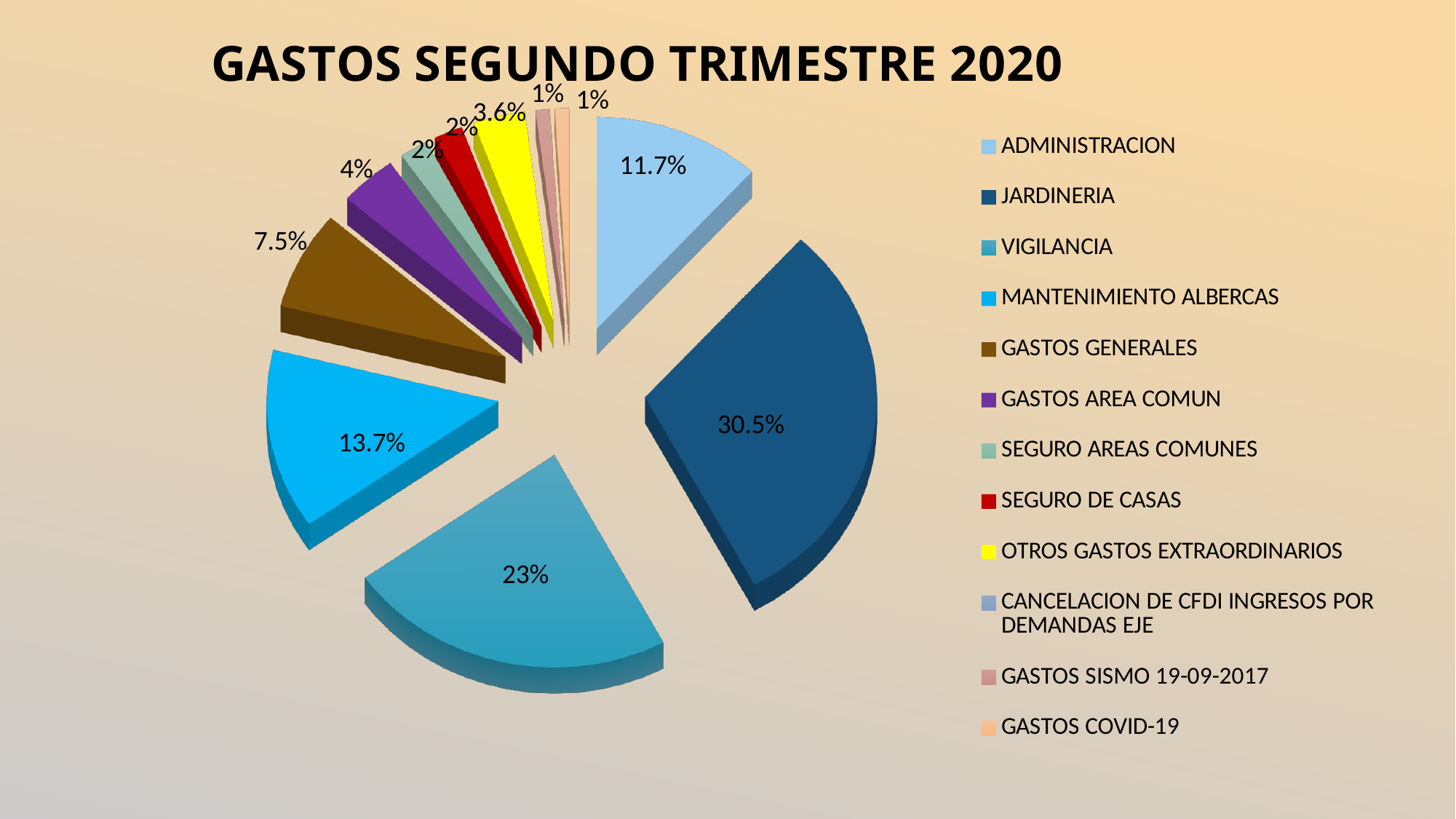
How many entries does the chart's legend list? 12 What percentage of the pie is JARDINERIA? 30.5% What kind of chart is shown on the slide? pie chart What percentage of the pie is VIGILANCIA? 23% What is the title of the chart? GASTOS SEGUNDO TRIMESTRE 2020 Which slice is larger, ADMINISTRACION or MANTENIMIENTO ALBERCAS? MANTENIMIENTO ALBERCAS What percentage of the pie is ADMINISTRACION? 11.7% What percentage of the pie is MANTENIMIENTO ALBERCAS? 13.7% What is the difference in percentage points between the JARDINERIA slice and the VIGILANCIA slice? 7.5 What percentage of the pie is GASTOS AREA COMUN? 4% Which category has the largest slice of the pie? JARDINERIA What percentage of the pie is GASTOS GENERALES? 7.5%